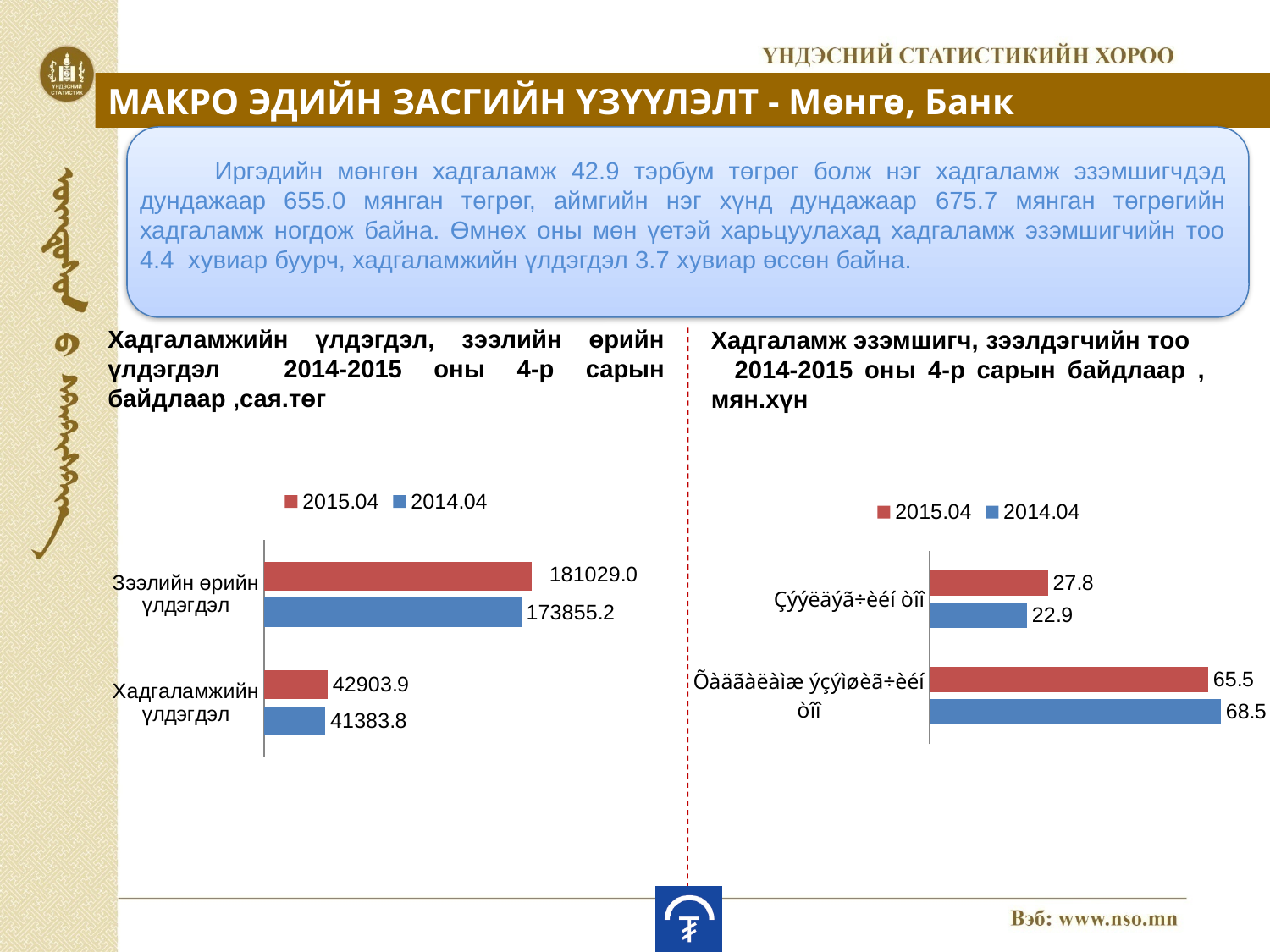
In the left chart (Хадгаламжийн үлдэгдэл, зээлийн өрийн үлдэгдэл), what is the difference between the 2015.04 and 2014.04 values for Зээлийн өрийн үлдэгдэл? 7173.8 In the left chart (Хадгаламжийн үлдэгдэл, зээлийн өрийн үлдэгдэл), what is the value for Хадгаламжийн үлдэгдэл in 2014.04? 41383.8 In the left chart (Хадгаламжийн үлдэгдэл, зээлийн өрийн үлдэгдэл), what is the value for Хадгаламжийн үлдэгдэл in 2015.04? 42903.9 In the left chart (Хадгаламжийн үлдэгдэл, зээлийн өрийн үлдэгдэл), which category has the highest value? Зээлийн өрийн үлдэгдэл In the right chart (Хадгаламж эзэмшигч, зээлдэгчийн тоо), what is the 2014.04 value for the bottom category? 68.5 In the right chart (Хадгаламж эзэмшигч, зээлдэгчийн тоо), what is the difference between the 2015.04 and 2014.04 values for the top category? 4.9 In the right chart (Хадгаламж эзэмшигч, зээлдэгчийн тоо), which colour represents the 2015.04 series? Red What kind of chart is the left chart (Хадгаламжийн үлдэгдэл, зээлийн өрийн үлдэгдэл)? Bar chart In the right chart (Хадгаламж эзэмшигч, зээлдэгчийн тоо), for the bottom category, which is larger: the 2015.04 value or the 2014.04 value? 2014.04 In the left chart (Хадгаламжийн үлдэгдэл, зээлийн өрийн үлдэгдэл), what is the value for Зээлийн өрийн үлдэгдэл in 2015.04? 181029.0 In the right chart (Хадгаламж эзэмшигч, зээлдэгчийн тоо), what is the 2015.04 value for the top category? 27.8 In the left chart (Хадгаламжийн үлдэгдэл, зээлийн өрийн үлдэгдэл), how many series does the legend list? 2